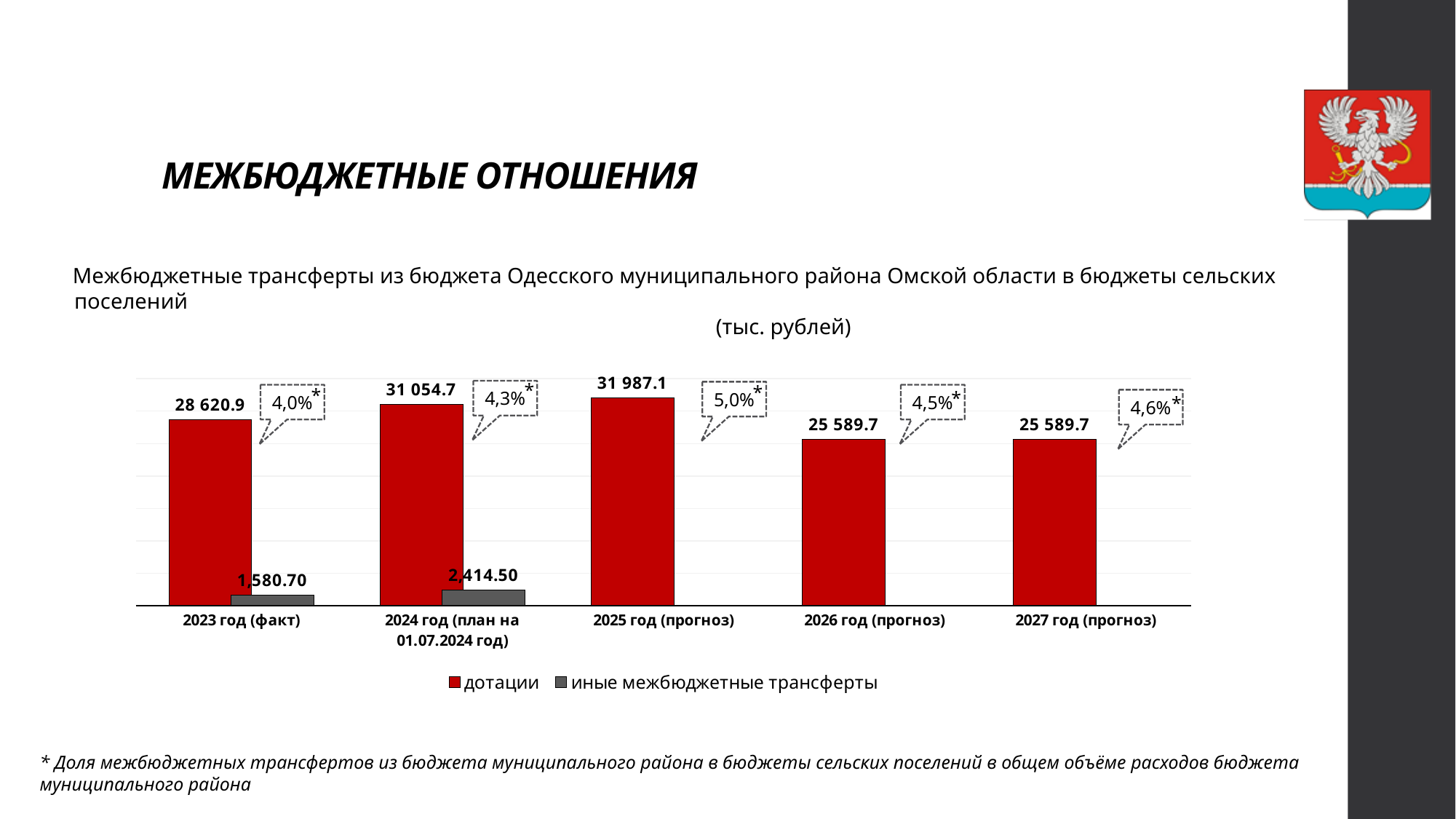
Which is larger: дотации in 2024 год (план на 01.07.2024 год) or in 2023 год (факт)? 2024 год (план на 01.07.2024 год) How many series does the legend list? 2 What colour are the bars for дотации? red What is the value of дотации for 2023 год (факт)? 28 620.9 What is the value of иные межбюджетные трансферты for 2023 год (факт)? 1,580.70 What is the difference between дотации in 2025 год (прогноз) and 2026 год (прогноз)? 6 397.4 Which year has the highest value of дотации? 2025 год (прогноз) What percentage is shown in the callout for 2025 год (прогноз)? 5,0% What type of chart is shown on the slide? bar chart How many year categories are shown on the x axis? 5 What is the value of дотации for 2025 год (прогноз)? 31 987.1 What is the value of иные межбюджетные трансферты for 2024 год (план на 01.07.2024 год)? 2,414.50